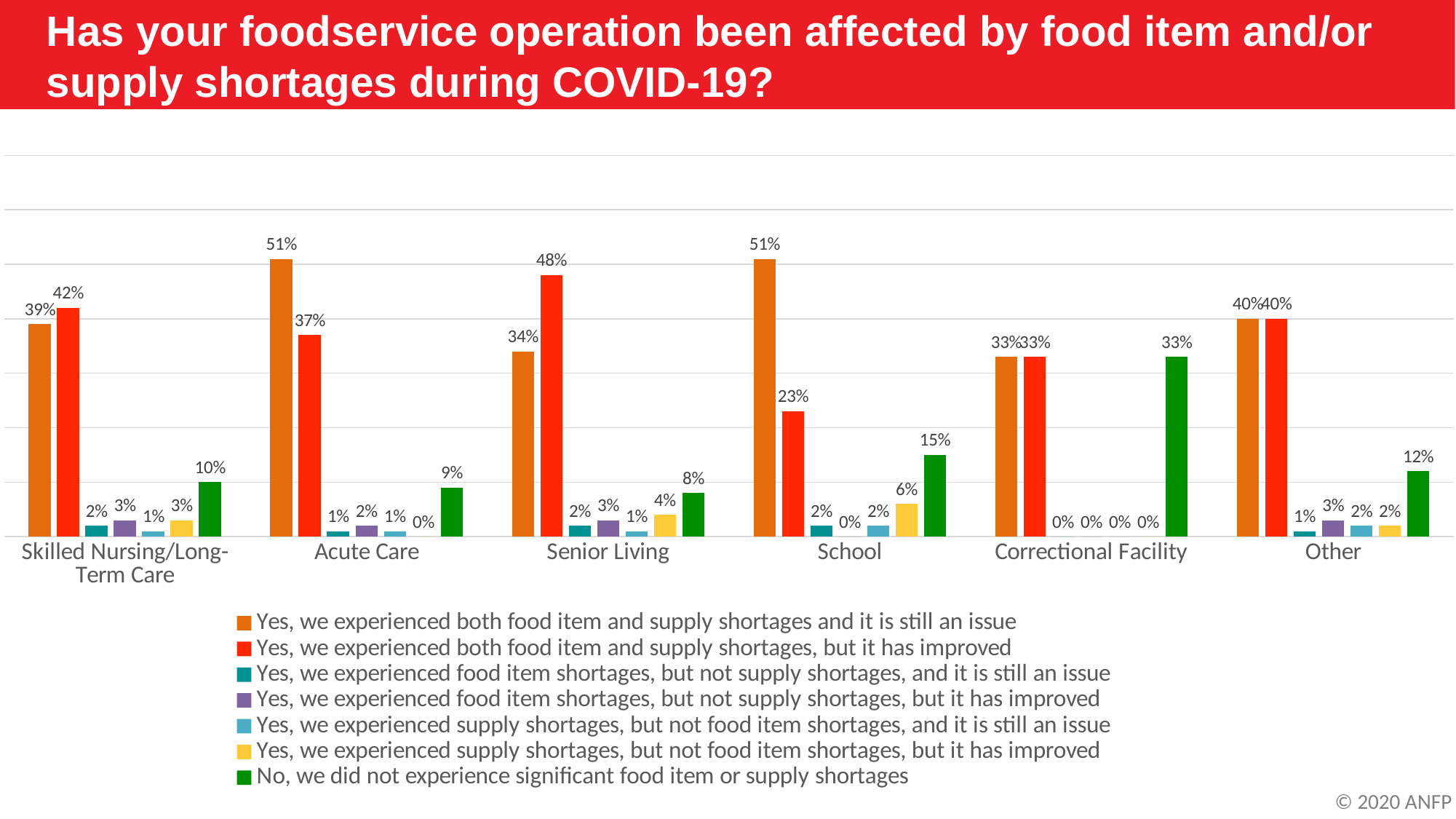
What percentage of School respondents said they experienced both food item and supply shortages and it is still an issue? 51% What kind of chart is shown on the slide? Bar chart How many series does the legend list? 7 What is the value for 'No, we did not experience significant food item or supply shortages' for the Other category? 12% Which category has the lowest value for 'Yes, we experienced both food item and supply shortages, but it has improved'? School Which category has the highest value for 'No, we did not experience significant food item or supply shortages'? Correctional Facility What is the difference between the 'both shortages, still an issue' value for Acute Care and the 'both shortages, but it has improved' value for Acute Care? 14% How many categories are shown on the x axis? 6 What percentage of Correctional Facility respondents said they did not experience significant food item or supply shortages? 33% What percentage of Senior Living respondents said they experienced both food item and supply shortages, but it has improved? 48% For Senior Living, which is larger: 'both shortages and it is still an issue' or 'both shortages, but it has improved'? Yes, we experienced both food item and supply shortages, but it has improved What percentage of Acute Care respondents said they experienced supply shortages, but not food item shortages, but it has improved? 0%